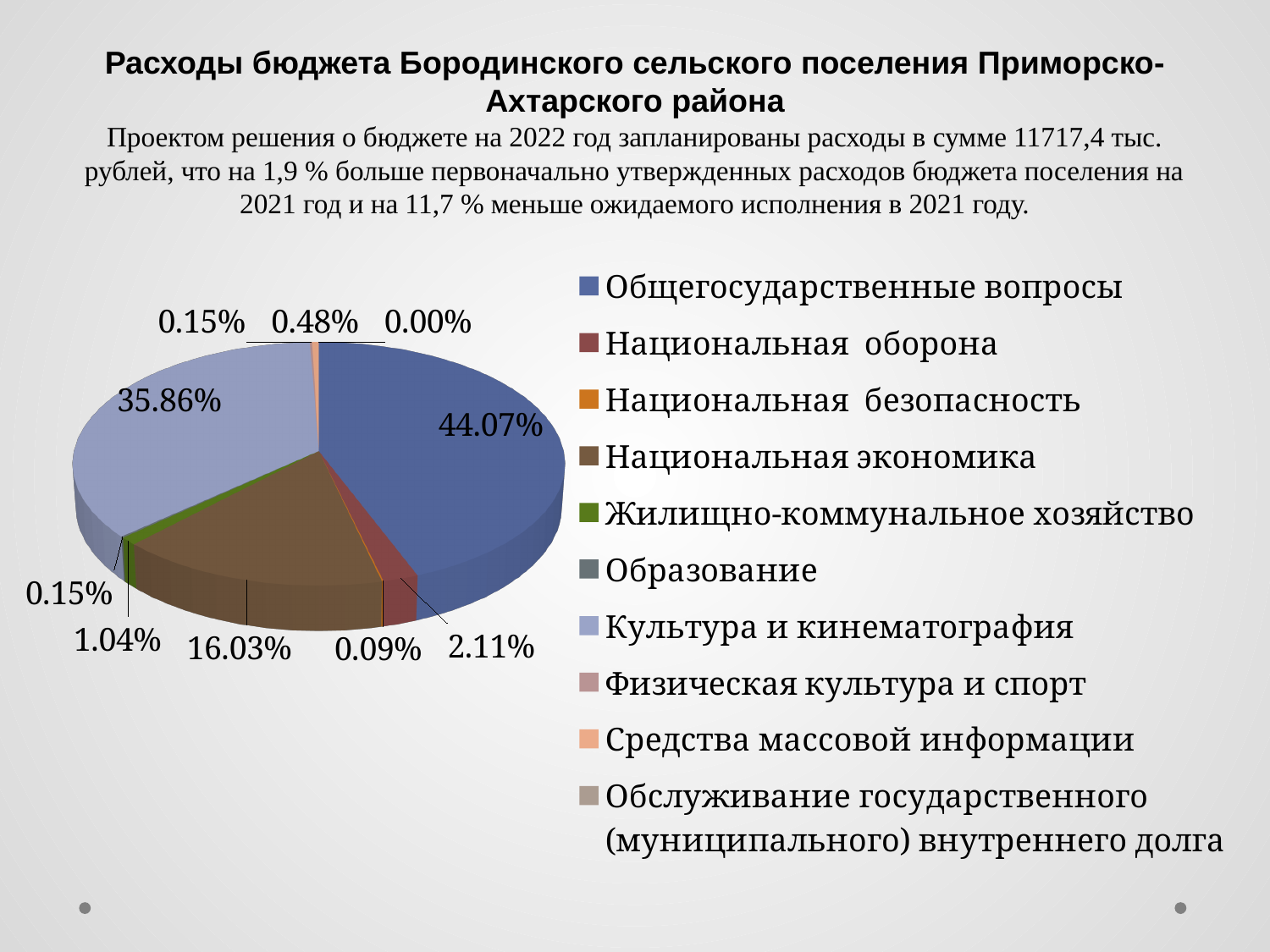
How many categories does the legend of the pie chart list? 10 What is the value shown for Национальная оборона? 2.11% What share of the pie does Культура и кинематография have? 35.86% Which category has the largest share of the pie chart? Общегосударственные вопросы What is the difference between the shares of Общегосударственные вопросы and Культура и кинематография? 8.21% What is the value shown for Средства массовой информации? 0.48% What is the value shown for Жилищно-коммунальное хозяйство? 1.04% What share of the pie does Общегосударственные вопросы have? 44.07% What is the value shown for Национальная экономика? 16.03% What kind of chart is shown on the slide? pie chart Which category has the smallest share of the pie chart? Обслуживание государственного (муниципального) внутреннего долга What is the value shown for Национальная безопасность? 0.09%